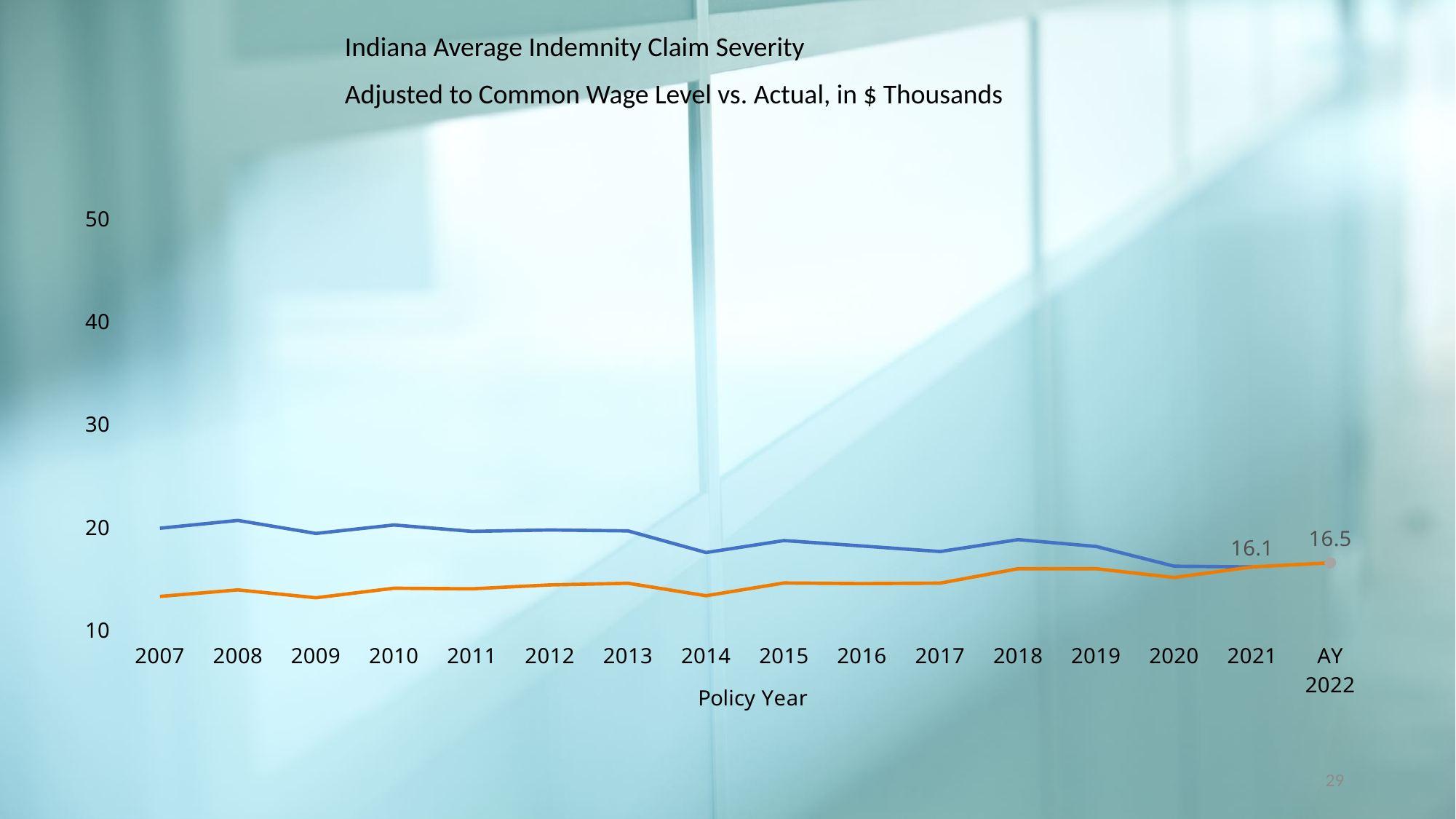
What is the label of the x axis? Policy Year What is the difference between the labelled values for AY 2022 and 2021? 0.4 Does the blue line generally rise or fall from 2008 to 2021? fall What is the labelled value for AY 2022? 16.5 How many policy years are plotted along the x axis? 16 What is the title of the chart? Indiana Average Indemnity Claim Severity Adjusted to Common Wage Level vs. Actual, in $ Thousands Which line is higher in 2010, the blue line or the orange line? the blue line What is the labelled value for 2021? 16.1 Is the value of the blue line for 2014 greater or less than 20? less What type of chart is shown on the slide? line chart Is the value of the orange line for 2007 greater or less than 20? less Does the orange line generally rise or fall from 2007 to AY 2022? rise